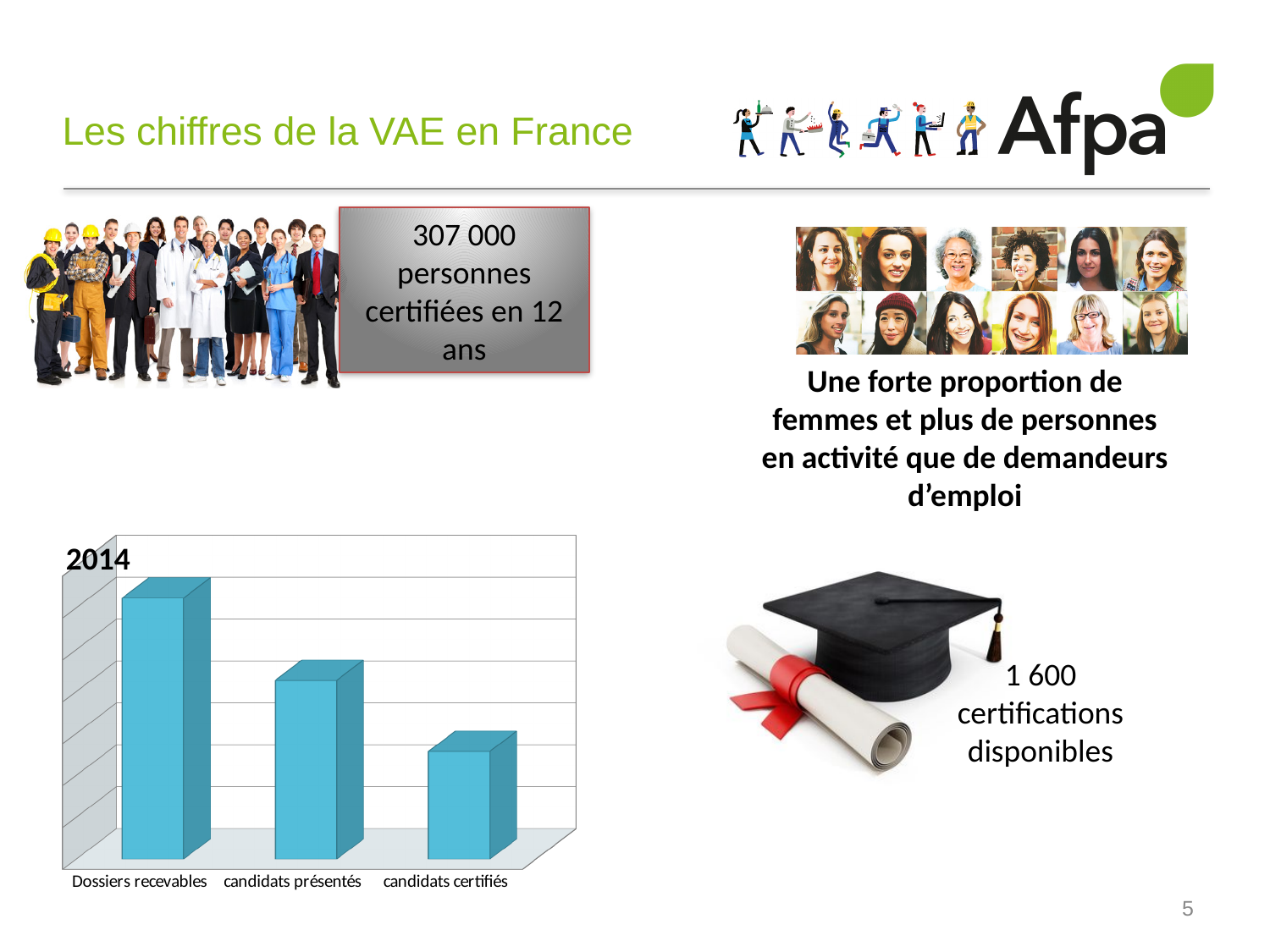
What is the title of the bar chart? 2014 What colour are the bars in the chart? blue Do the bars rise or fall from left to right across the chart? fall Which category has the lowest bar in the chart? candidats certifiés Which category has the highest bar in the chart? Dossiers recevables Which is larger in the chart, candidats présentés or candidats certifiés? candidats présentés What kind of chart is shown on the slide? bar chart What is the label of the middle category in the bar chart? candidats présentés Which is larger in the chart, Dossiers recevables or candidats présentés? Dossiers recevables How many categories does the bar chart show? 3